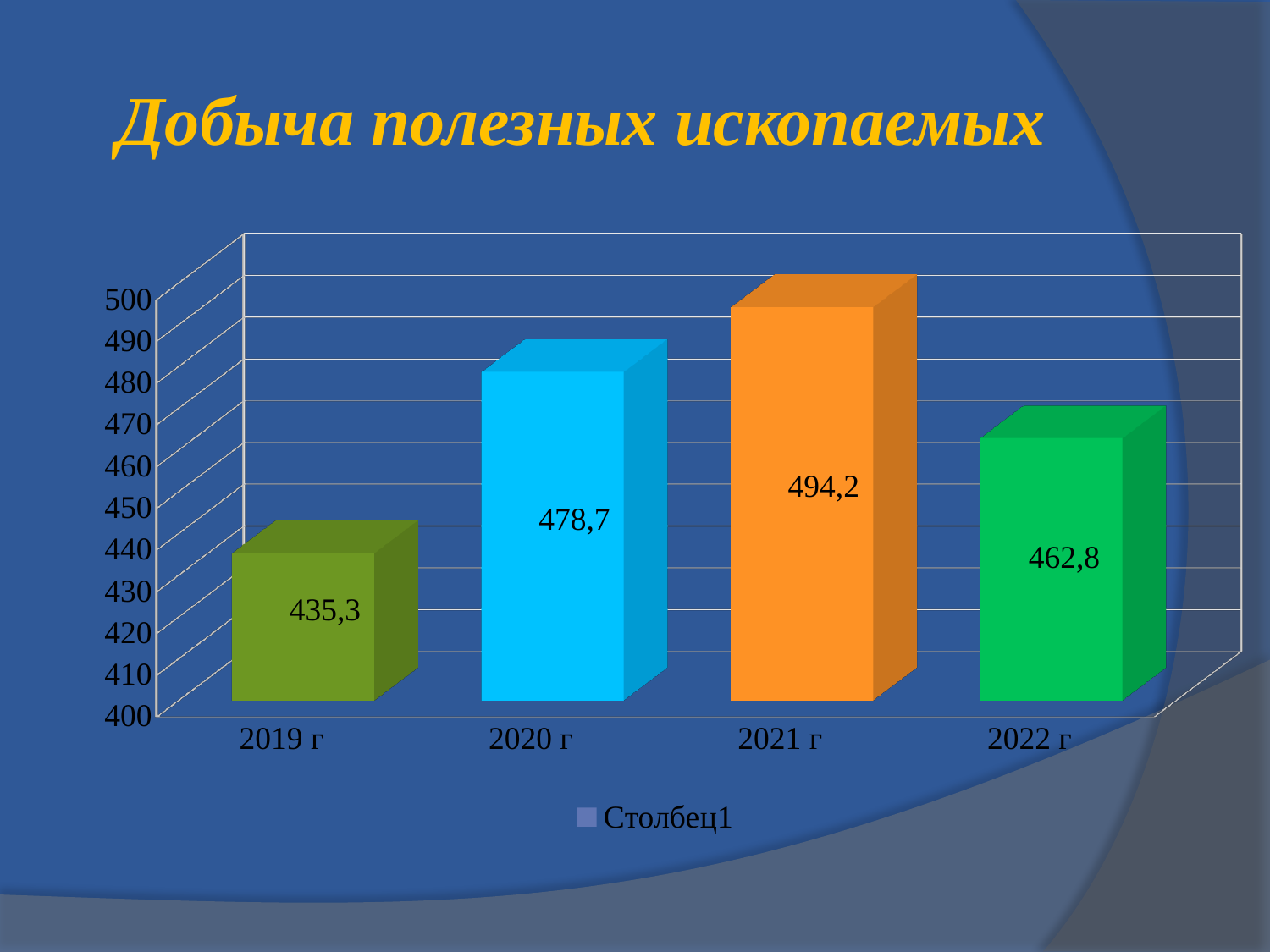
What is the value for 2021 г? 494,2 What is the value for 2019 г? 435,3 How many years are shown on the x axis? 4 What kind of chart is shown on the slide? bar chart Is the value for 2021 г greater or less than 490? greater What is the difference between the values for 2021 г and 2019 г? 58,9 Which is larger, the value for 2020 г or the value for 2022 г? 2020 г What is the value for 2022 г? 462,8 Which year has the lowest value? 2019 г Which year has the highest value? 2021 г What is the title of the chart on the slide? Добыча полезных ископаемых What is the difference between the values for 2020 г and 2022 г? 15,9